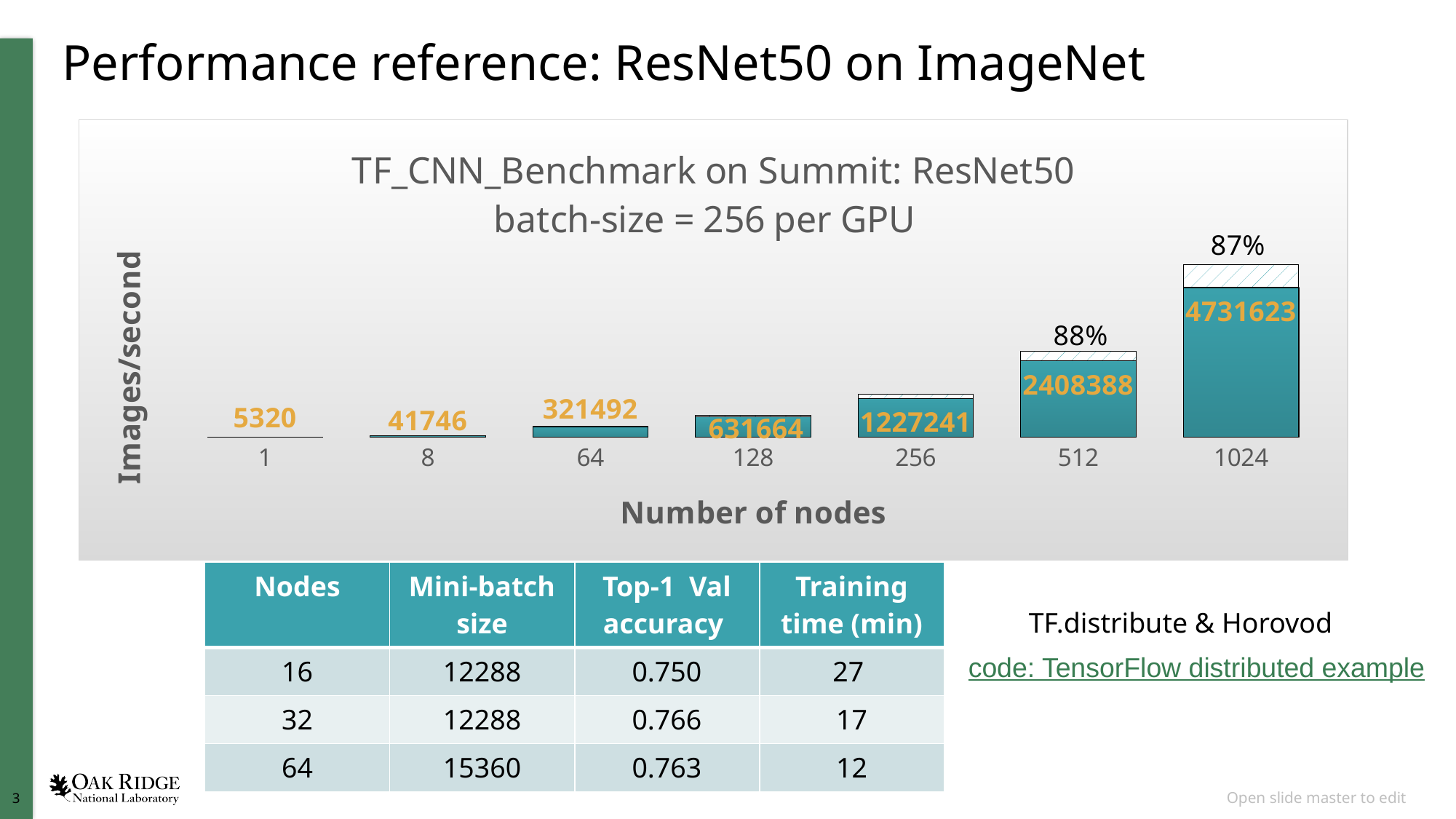
What kind of chart is shown on the slide? Bar chart Which number of nodes has the highest images/second? 1024 Which has a higher images/second value, 128 nodes or 256 nodes? 256 nodes Which number of nodes has the lowest images/second? 1 Do the images/second values rise or fall as the number of nodes increases? Rise What is the images/second value for 256 nodes? 1227241 What is the images/second value for 1 node? 5320 What percentage is labeled above the bar for 512 nodes? 88% What is the images/second value for 1024 nodes? 4731623 What is the images/second value for 64 nodes? 321492 What is the difference in images/second between 1024 nodes and 512 nodes? 2323235 How many node counts are shown on the x axis of the chart? 7